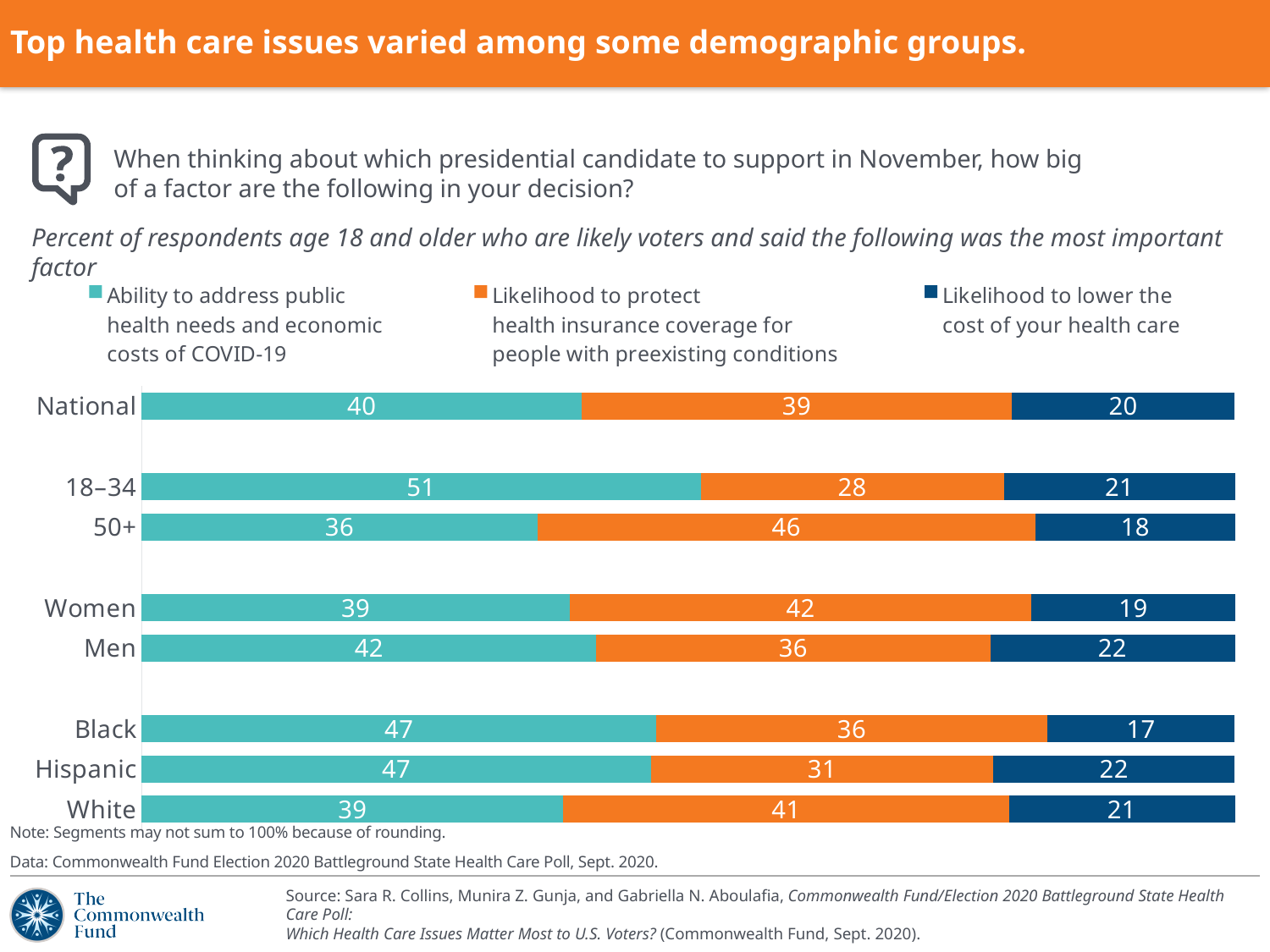
Which colour represents likelihood to lower the cost of your health care? Dark blue How many demographic groups are shown on the chart? 8 What kind of chart is shown on the slide? Stacked bar chart What is the difference between the 18–34 and 50+ values for ability to address public health needs and economic costs of COVID-19? 15 What is the value for the 50+ group for likelihood to protect health insurance coverage for people with preexisting conditions? 46 What is the total of the three segments for the Men bar? 100 Which demographic group has the lowest value for likelihood to lower the cost of your health care? Black What is the value for Hispanic respondents for likelihood to lower the cost of your health care? 22 For Women, which is larger: the value for ability to address COVID-19 or the value for likelihood to protect coverage for people with preexisting conditions? Likelihood to protect health insurance coverage for people with preexisting conditions How many series does the legend list? 3 What percentage of National respondents said the ability to address public health needs and economic costs of COVID-19 was the most important factor? 40 Which demographic group has the highest value for ability to address public health needs and economic costs of COVID-19? 18–34